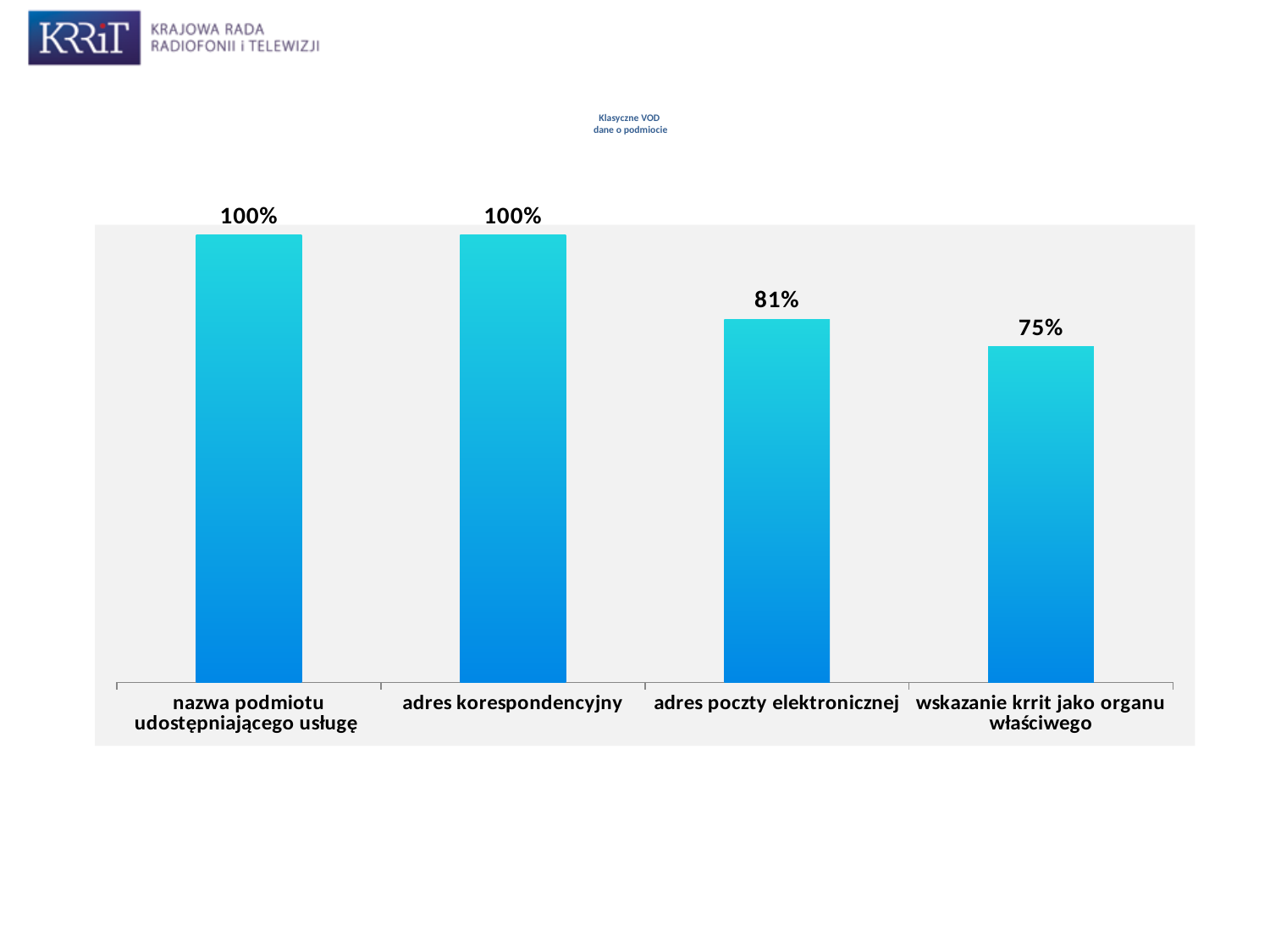
What is the difference between the values for "adres korespondencyjny" and "adres poczty elektronicznej"? 19% Which is larger, the value for "adres poczty elektronicznej" or the value for "wskazanie krrit jako organu właściwego"? adres poczty elektronicznej What is the value for "wskazanie krrit jako organu właściwego"? 75% Do the values rise or fall from left to right across the categories? fall What is the value for "nazwa podmiotu udostępniającego usługę"? 100% What is the value for "adres korespondencyjny"? 100% What is the value for "adres poczty elektronicznej"? 81% What kind of chart is shown on the slide? bar chart How many categories are shown in the chart? 4 What is the difference between the values for "adres poczty elektronicznej" and "wskazanie krrit jako organu właściwego"? 6% What is the title of the chart? Klasyczne VOD dane o podmiocie Which category has the lowest value? wskazanie krrit jako organu właściwego